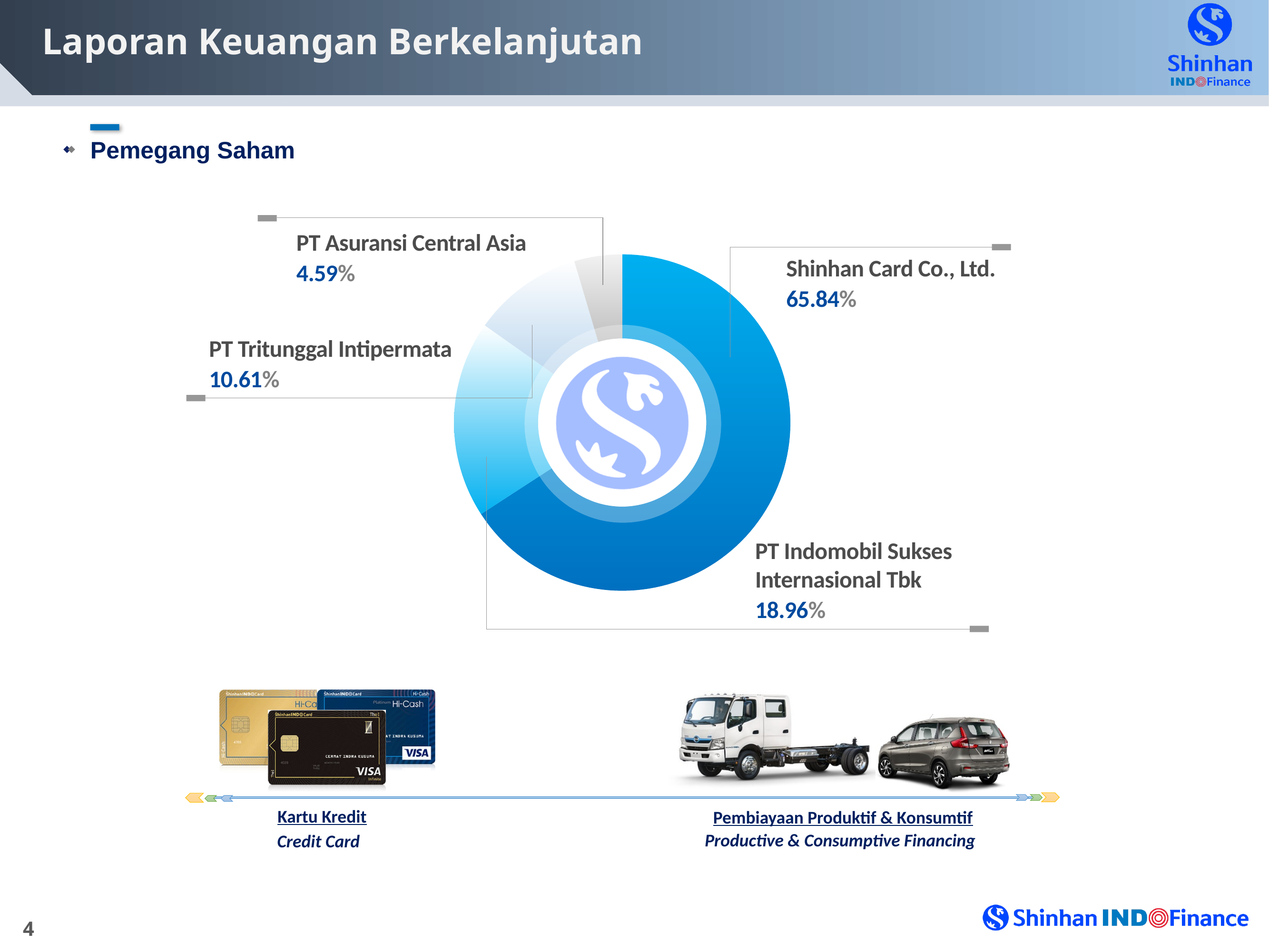
What percentage of shares does PT Indomobil Sukses Internasional Tbk hold? 18.96% How many shareholders are shown in the chart? 4 What is the difference in percentage points between the shares of PT Tritunggal Intipermata and PT Asuransi Central Asia? 6.02 Which shareholder holds the smallest share? PT Asuransi Central Asia What kind of chart is used to show the shareholders? Doughnut chart What percentage of shares does PT Tritunggal Intipermata hold? 10.61% What percentage of shares does PT Asuransi Central Asia hold? 4.59% Which holds a larger share, PT Tritunggal Intipermata or PT Indomobil Sukses Internasional Tbk? PT Indomobil Sukses Internasional Tbk What percentage of shares does Shinhan Card Co., Ltd. hold? 65.84% Which shareholder holds the largest share? Shinhan Card Co., Ltd. What is the heading above the shareholder chart? Pemegang Saham What is the difference in percentage points between the shares of Shinhan Card Co., Ltd. and PT Indomobil Sukses Internasional Tbk? 46.88